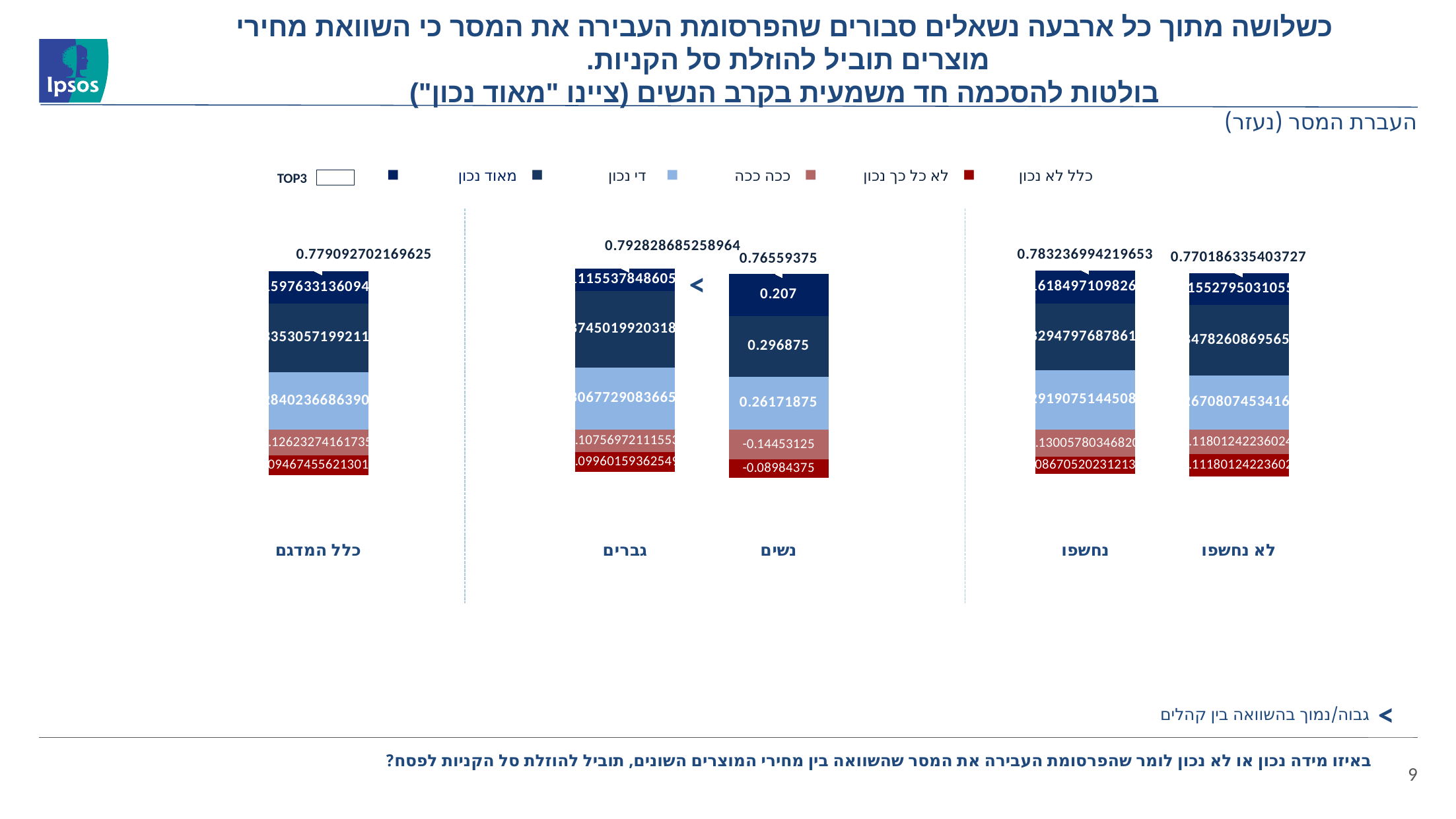
What is the TOP3 value printed above the bar for גברים? 0.792828685258964 Which category has the lowest TOP3 value? נשים What is the TOP3 value printed above the bar for כלל המדגם? 0.779092702169625 What is the difference between the TOP3 values for גברים and נשים? 0.027234935258964 What is the value of the ככה ככה segment for נשים? 0.26171875 What is the TOP3 value printed above the bar for נשים? 0.76559375 Which has a higher TOP3 value, נחשפו or לא נחשפו? נחשפו What is the value of the מאוד נכון segment for נשים? 0.207 What kind of chart is shown on the slide? Stacked bar chart How many categories (bars) are shown along the x axis? 5 Which category has the highest TOP3 value? גברים How many entries does the legend list? 6